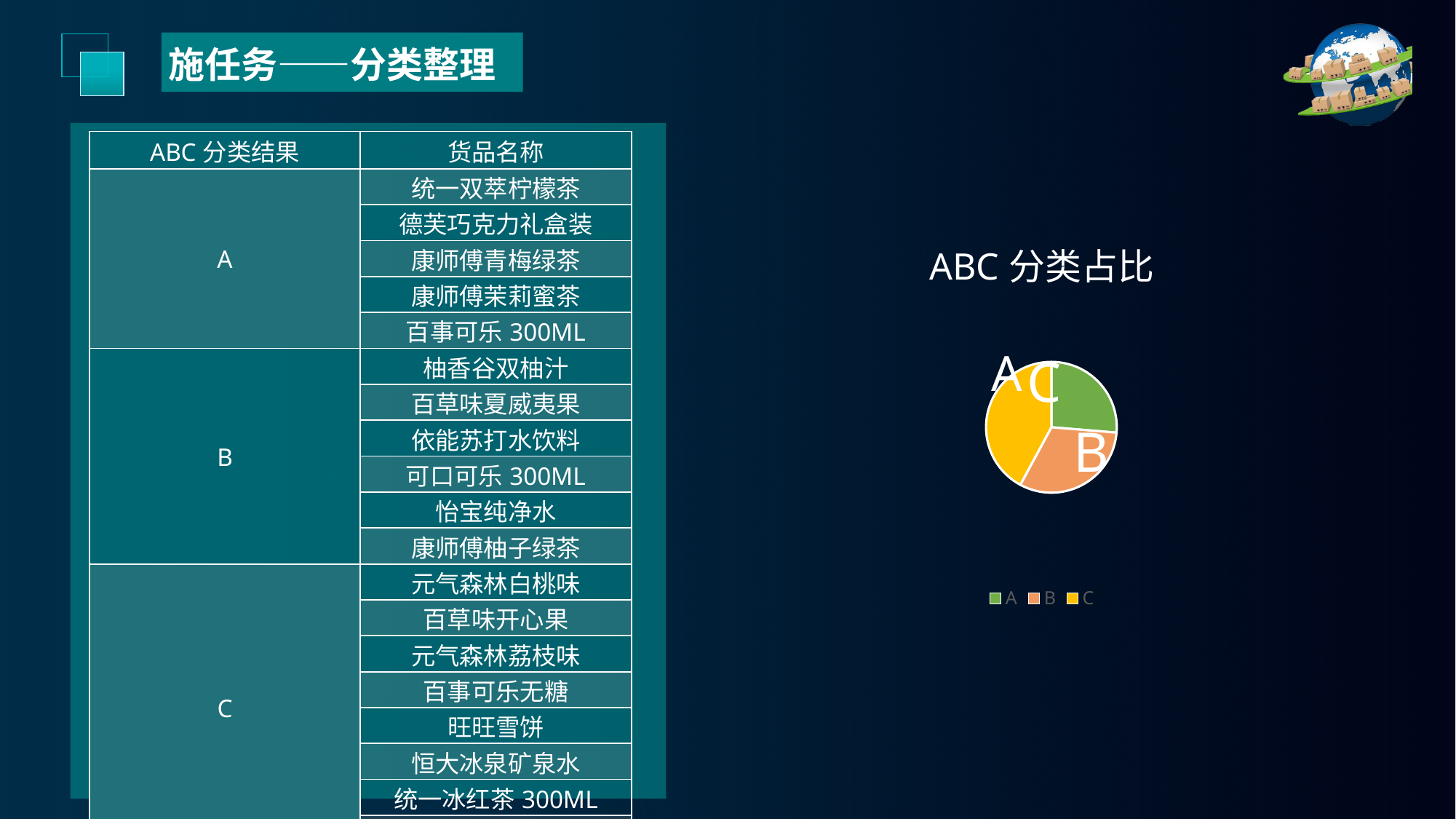
How many entries does the legend of the pie chart list? 3 How many slices does the pie chart have? 3 In the pie chart, which slice is larger, C or A? C Which colour represents category B in the pie chart? orange In the pie chart, which slice is larger, B or C? C What kind of chart is shown on the slide? pie chart What is the title of the chart on the slide? ABC 分类占比 Which category has the largest slice in the pie chart? C